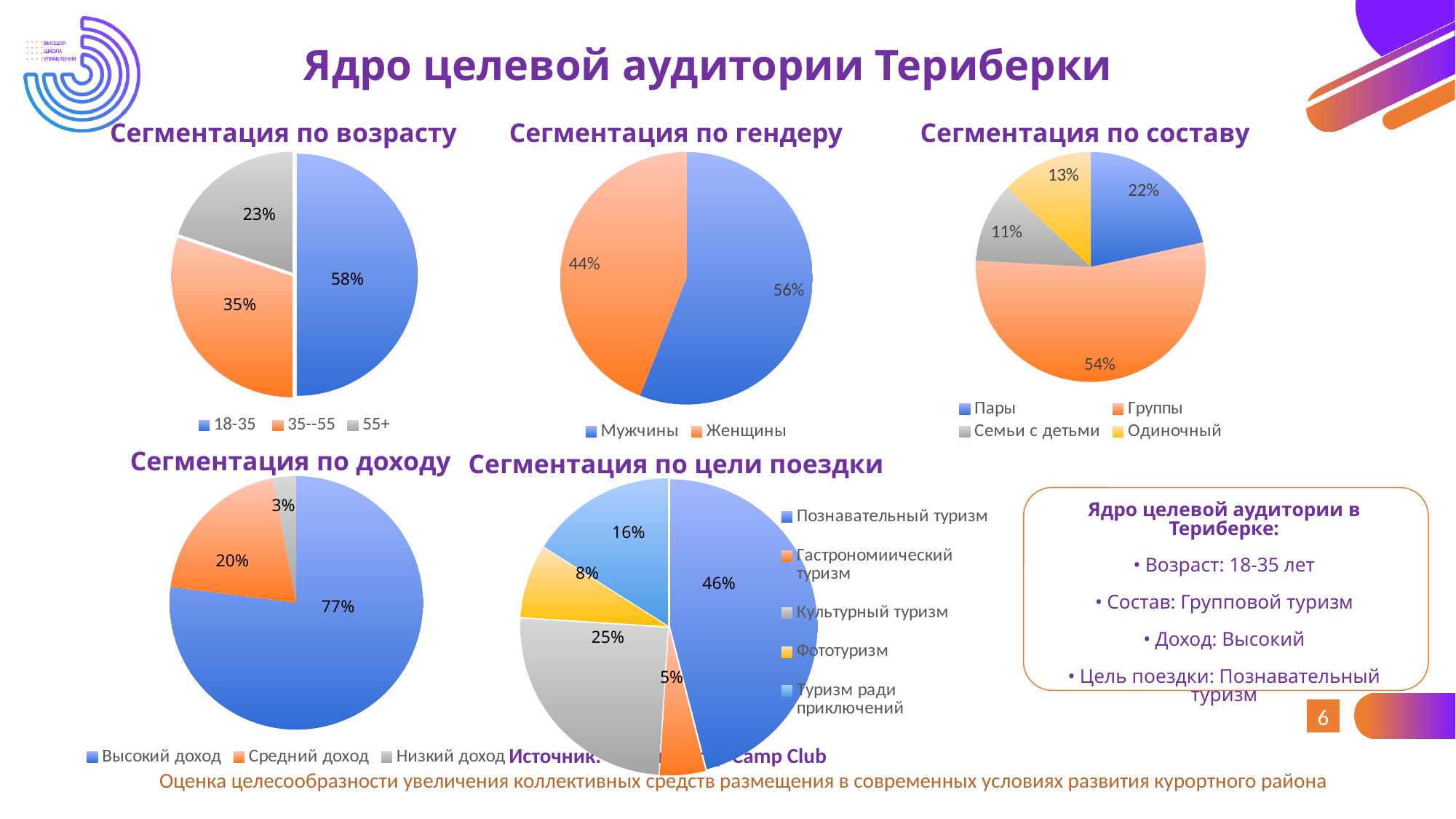
In the chart titled "Сегментация по составу", how many categories does the legend list? 4 In the chart titled "Сегментация по гендеру", what is the difference between the Мужчины and Женщины shares? 12% In the chart titled "Сегментация по доходу", which is larger, Высокий доход or Средний доход? Высокий доход In the chart titled "Сегментация по доходу", what share does Низкий доход have? 3% In the chart titled "Сегментация по составу", what is the value for Семьи с детьми? 11% In the chart titled "Сегментация по возрасту", which age group has the smallest slice? 55+ In the chart titled "Сегментация по гендеру", what is the value for Женщины? 44% In the chart titled "Сегментация по цели поездки", what is the value for Культурный туризм? 25% In the chart titled "Сегментация по составу", which category has the largest slice? Группы In the chart titled "Сегментация по цели поездки", how many categories are shown? 5 What type of chart is used for "Сегментация по цели поездки"? Pie chart In the chart titled "Сегментация по возрасту", what share does the 18-35 group have? 58%